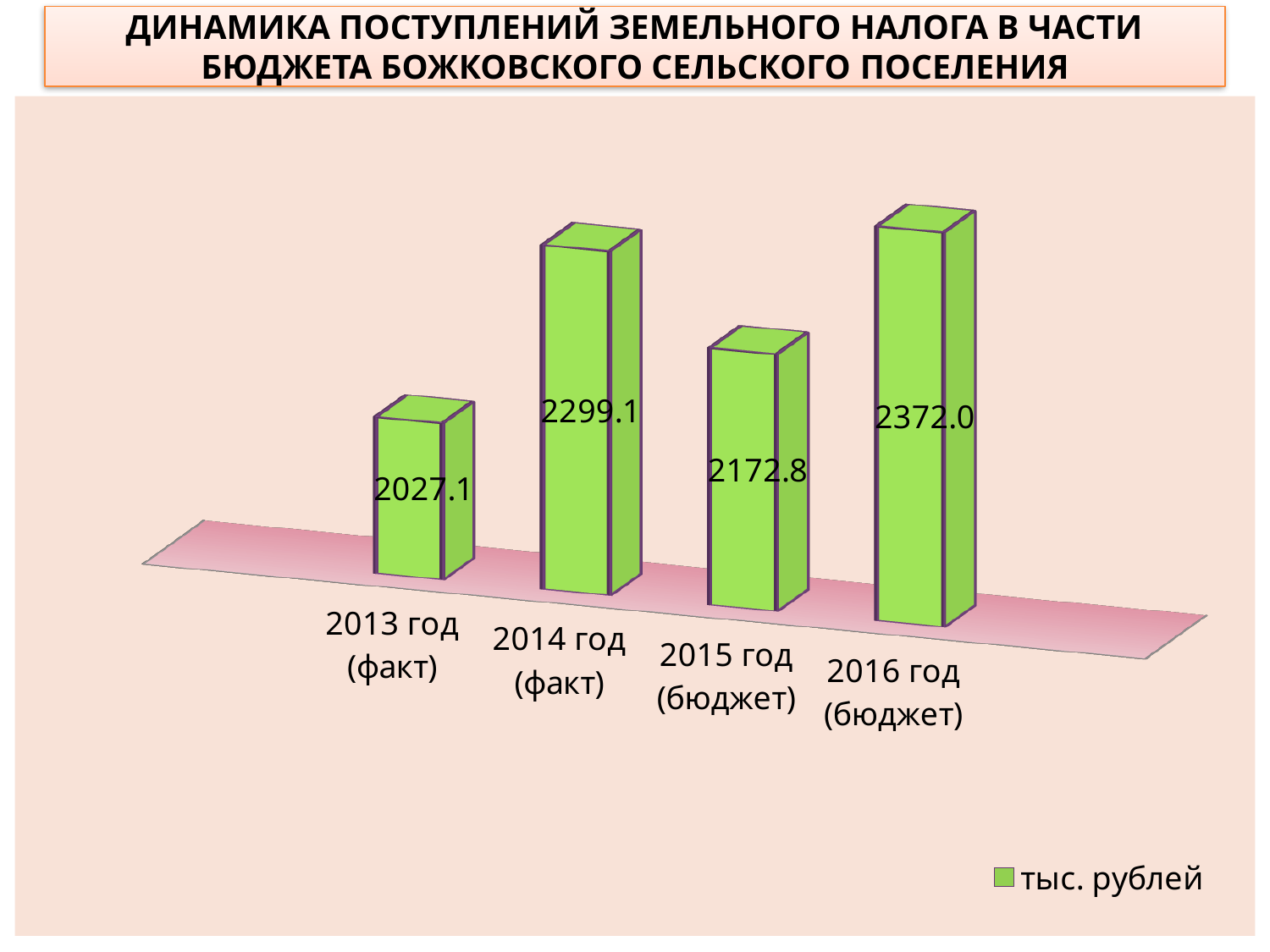
What is the value for 2016 год (бюджет)? 2372.0 Which category has the lowest value? 2013 год (факт) Which category has the highest value? 2016 год (бюджет) What is the difference between the values for 2016 год (бюджет) and 2015 год (бюджет)? 199.2 How many series does the legend list? 1 What is the value for 2015 год (бюджет)? 2172.8 How many categories are shown on the chart? 4 What is the legend entry shown on the chart? тыс. рублей What kind of chart is shown on the slide? bar chart Which is larger, the value for 2014 год (факт) or 2015 год (бюджет)? 2014 год (факт) What is the value for 2013 год (факт)? 2027.1 What is the difference between the values for 2014 год (факт) and 2013 год (факт)? 272.0